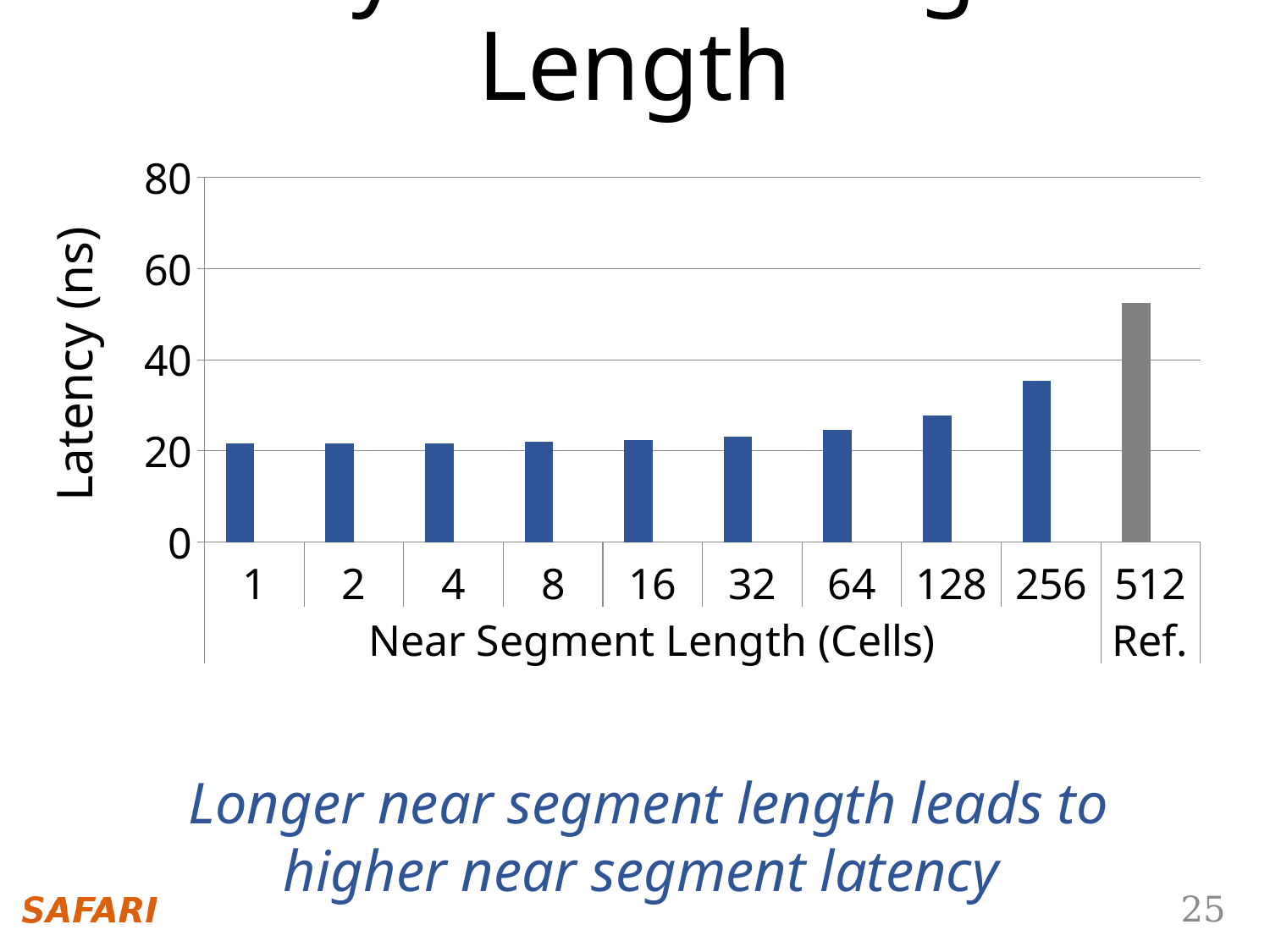
Is the latency for 512 Ref. greater or less than 40 ns? greater Is the latency for a near segment length of 128 cells greater or less than 40 ns? less Which has the higher latency: 512 Ref. or near segment length 256? 512 Ref. What kind of chart is shown on the slide? bar chart How many bars are plotted in the chart? 10 Do the latency values rise or fall as the near segment length increases from 1 to 256 cells? rise Is the latency for a near segment length of 256 cells greater or less than 20 ns? greater What colour is the 512 Ref. bar? gray Which has the higher latency: near segment length 256 or 128? 256 Which category has the highest latency? 512 Ref. What is the label of the y axis? Latency (ns)